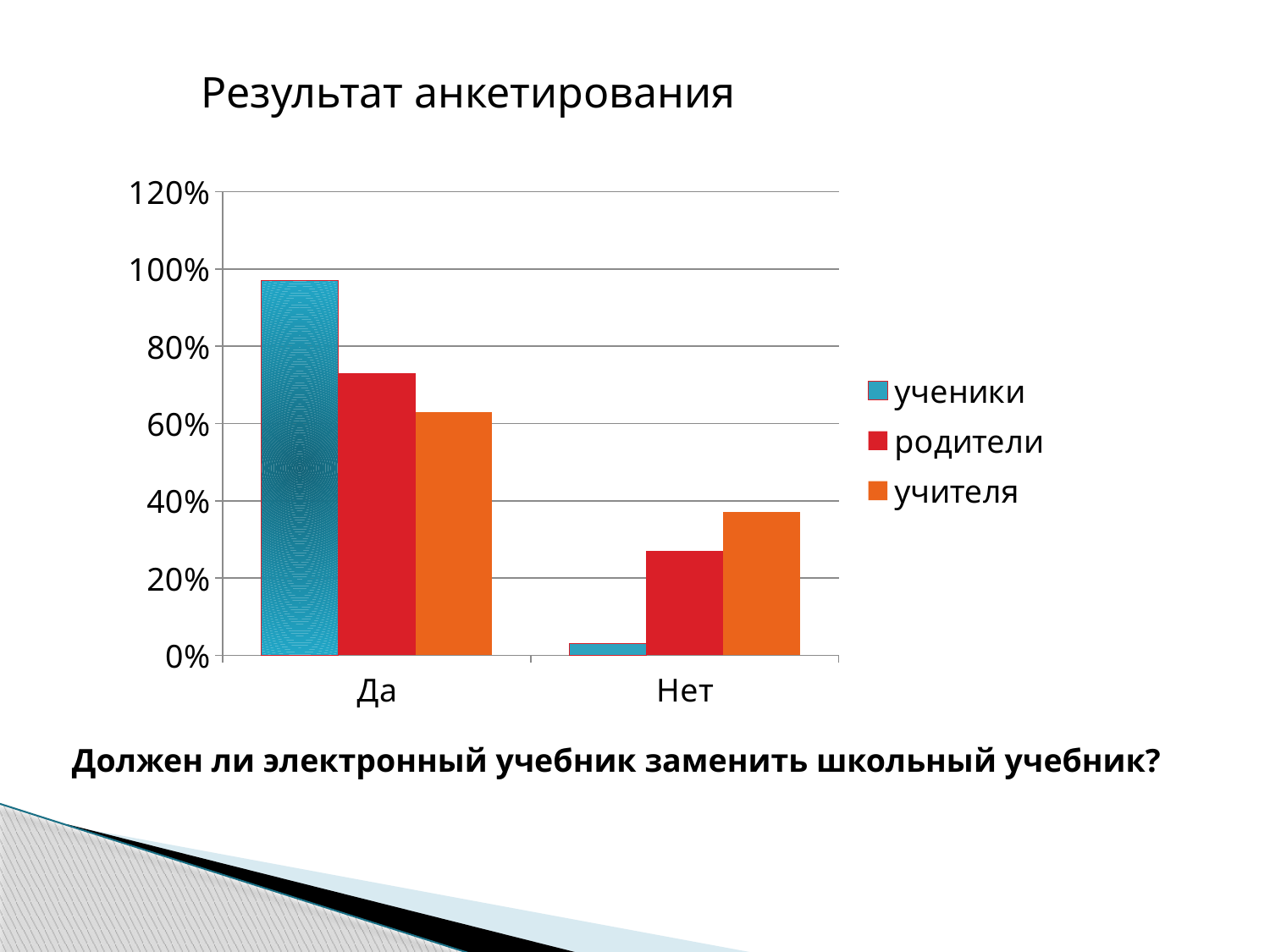
Is the value for родители in the "Нет" category greater or less than 40%? less What is the title of the chart? Результат анкетирования Is the value for ученики in the "Да" category greater or less than 80%? greater Which series has the highest value for "Нет"? учителя Which series has the lowest value for "Нет"? ученики What kind of chart is shown on the slide? bar chart How many categories are shown on the x axis? 2 How many series does the legend list? 3 Which series has the highest value for "Да"? ученики Which is larger: the value for родители for "Да" or the value for родители for "Нет"? Да Which colour represents the series "учителя" in the legend? orange Is the value for учителя in the "Да" category greater or less than 80%? less